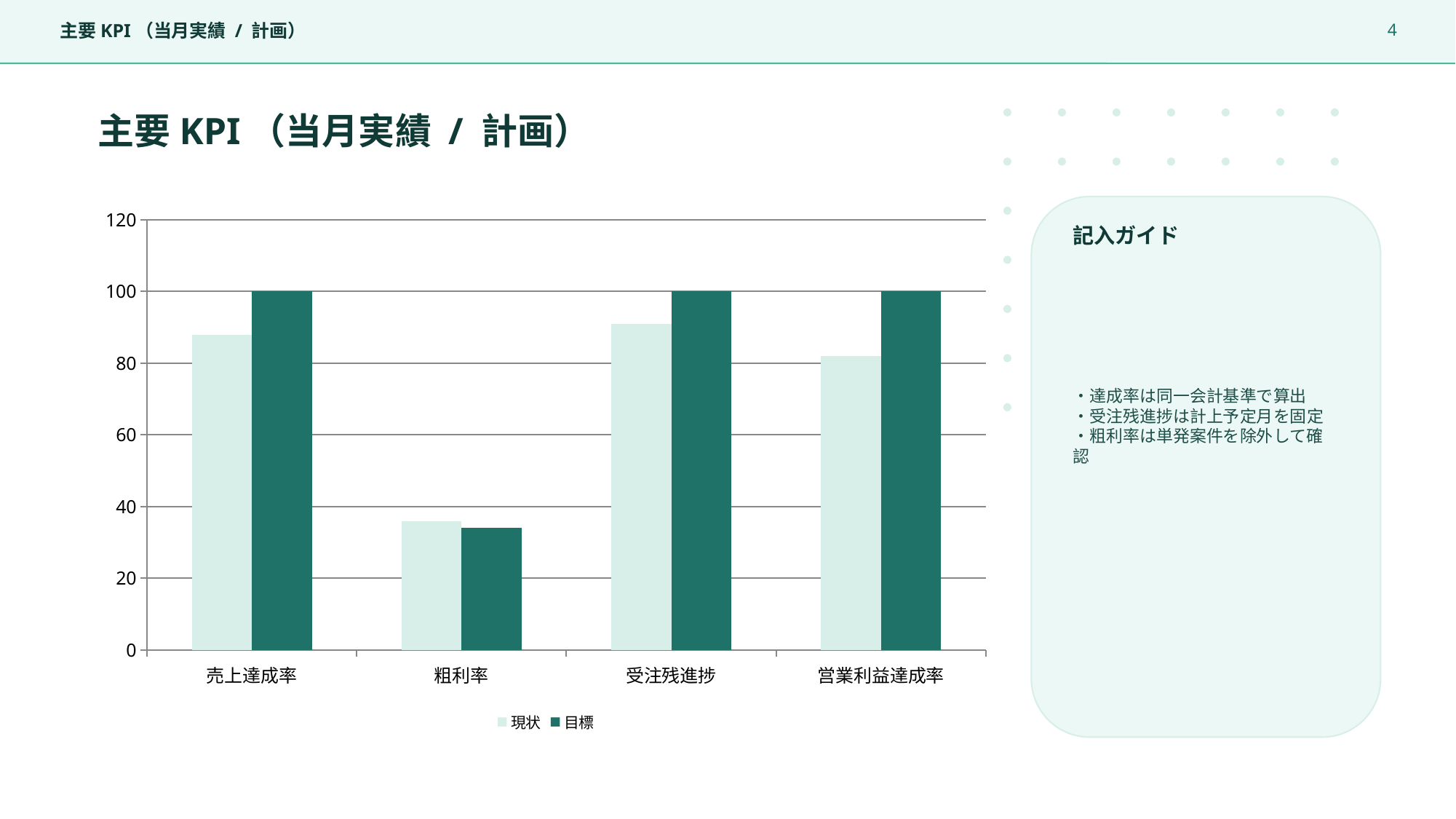
What are the two series listed in the chart's legend? 現状 and 目標 What is the 目標 value for 売上達成率? 100 Is the 現状 value for 売上達成率 greater or less than 80? greater What kind of chart is shown on the slide? bar chart For 営業利益達成率, which is larger: the 現状 value or the 目標 value? 目標 How many series does the chart's legend list? 2 How many categories are shown on the x axis of the chart? 4 Is the 現状 value for 粗利率 greater or less than 40? less What is the 目標 value for 営業利益達成率? 100 What is the 目標 value for 受注残進捗? 100 Is the 現状 value for 営業利益達成率 greater or less than 100? less Which category has the lowest 現状 value? 粗利率